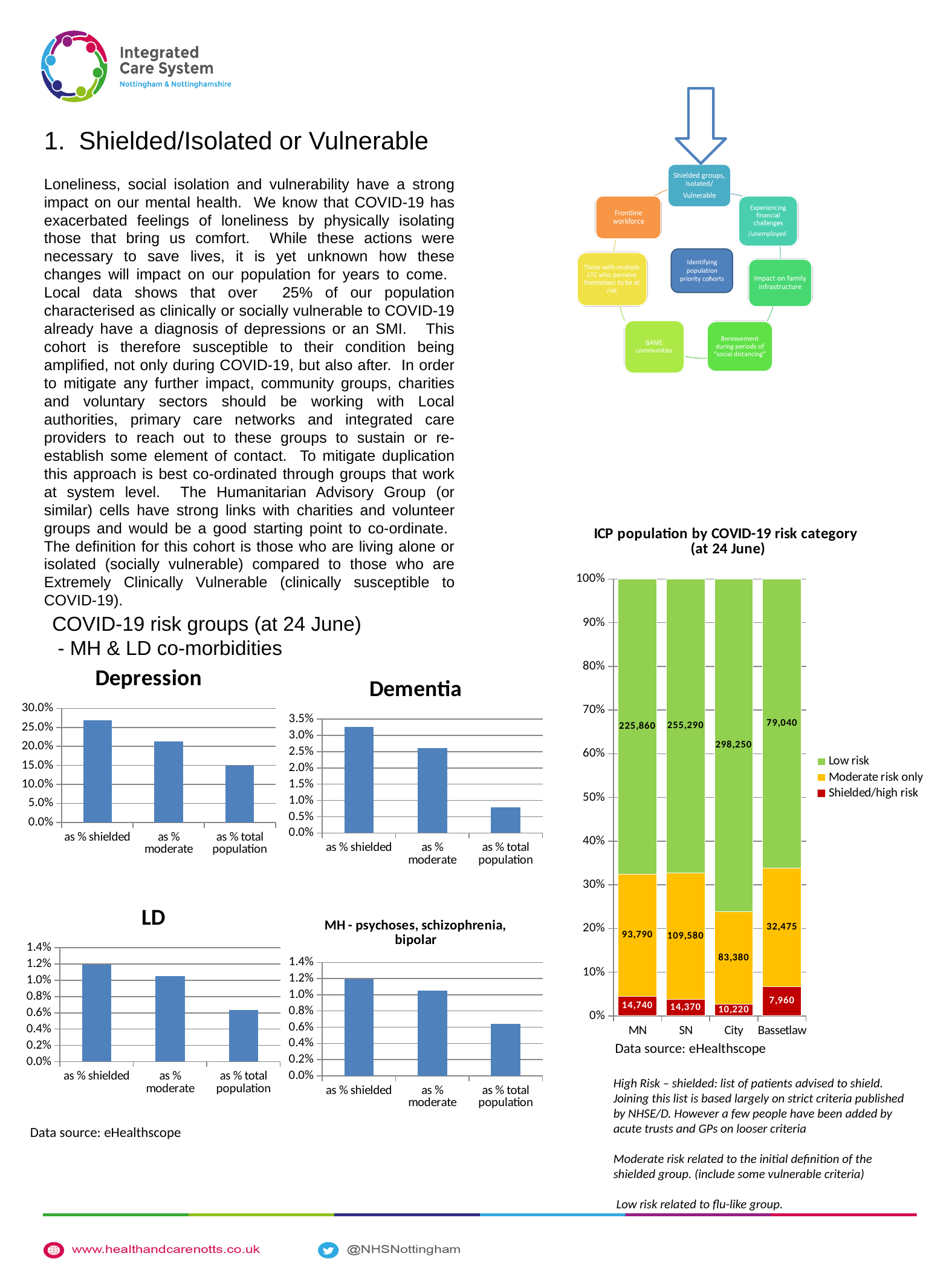
In the 'Depression' chart, is the value for 'as % shielded' greater or less than 25.0%? greater In the 'LD' chart, do the values rise or fall from left to right along the x axis? fall In the 'ICP population by COVID-19 risk category (at 24 June)' chart, what is the Low risk value for City? 298,250 In the 'ICP population by COVID-19 risk category (at 24 June)' chart, which area has the highest Moderate risk only value? SN In the 'ICP population by COVID-19 risk category (at 24 June)' chart, what is the Shielded/high risk value for Bassetlaw? 7,960 In the 'Dementia' chart, is the value for 'as % total population' greater or less than 1.0%? less In the 'ICP population by COVID-19 risk category (at 24 June)' chart, which area has the lowest Low risk value? Bassetlaw In the 'ICP population by COVID-19 risk category (at 24 June)' chart, how many series does the legend list? 3 In the 'ICP population by COVID-19 risk category (at 24 June)' chart, what is the difference between the Low risk values for City and SN? 42,960 What kind of chart is the 'MH - psychoses, schizophrenia, bipolar' chart? bar chart In the 'ICP population by COVID-19 risk category (at 24 June)' chart, is the Shielded/high risk value larger for MN or SN? MN In the 'ICP population by COVID-19 risk category (at 24 June)' chart, what is the total population across all three risk categories for MN? 334,390